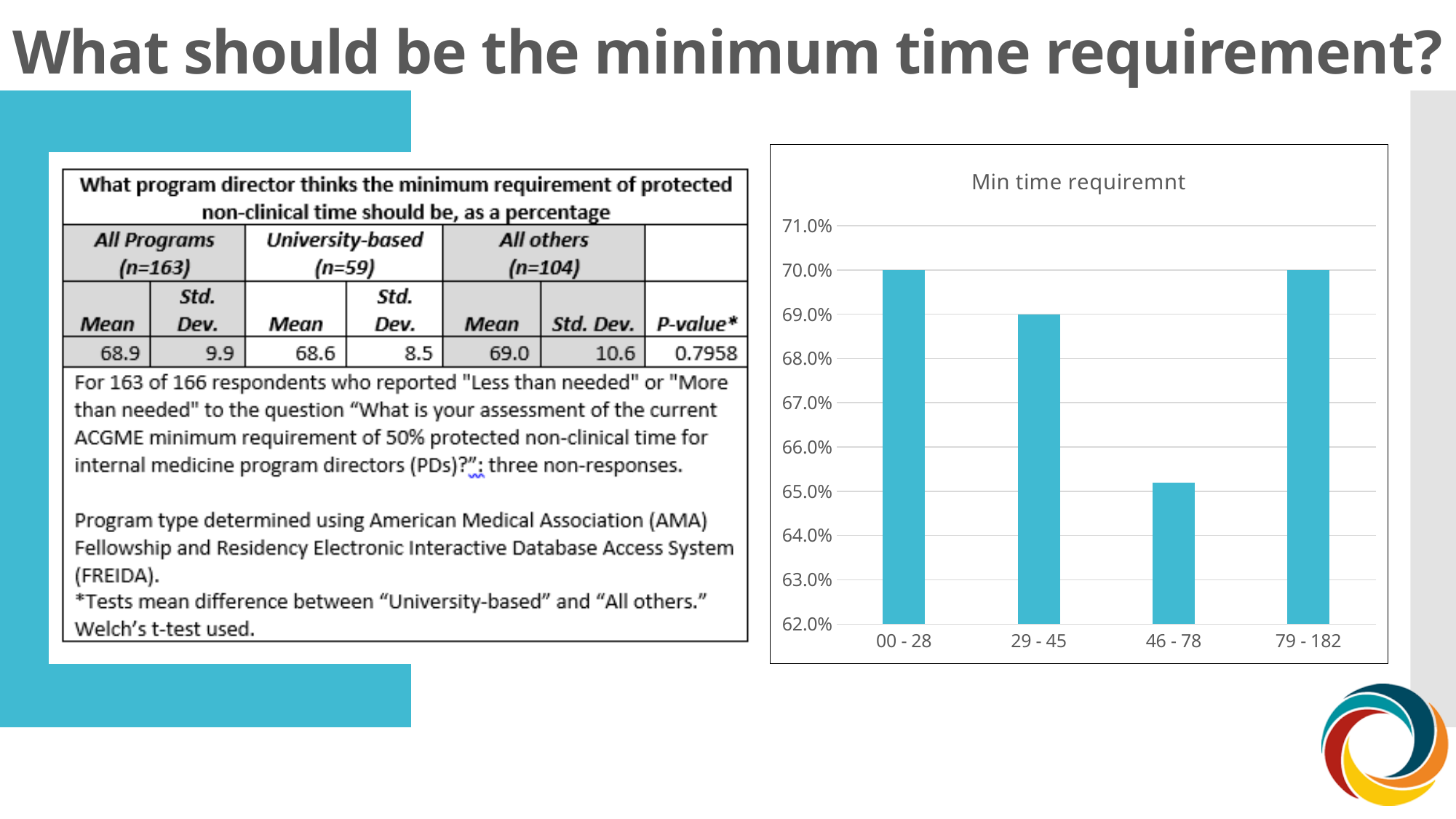
What is the difference between the values for 00 - 28 and 29 - 45? 1.0% Which category has the lowest value in the chart? 46 - 78 What is the value for the 00 - 28 category in the chart? 70.0% What kind of chart is shown on the right side of the slide? bar chart Is the value for 46 - 78 greater or less than 66.0%? less Which is larger, the value for 29 - 45 or the value for 46 - 78? 29 - 45 Do the values rise or fall from 00 - 28 to 46 - 78 along the x axis? fall How many categories are shown on the x axis of the chart? 4 What is the value for the 79 - 182 category in the chart? 70.0% What is the value for the 29 - 45 category in the chart? 69.0% Is the value for 29 - 45 greater or less than 68.0%? greater What is the title of the chart on the slide? Min time requiremnt